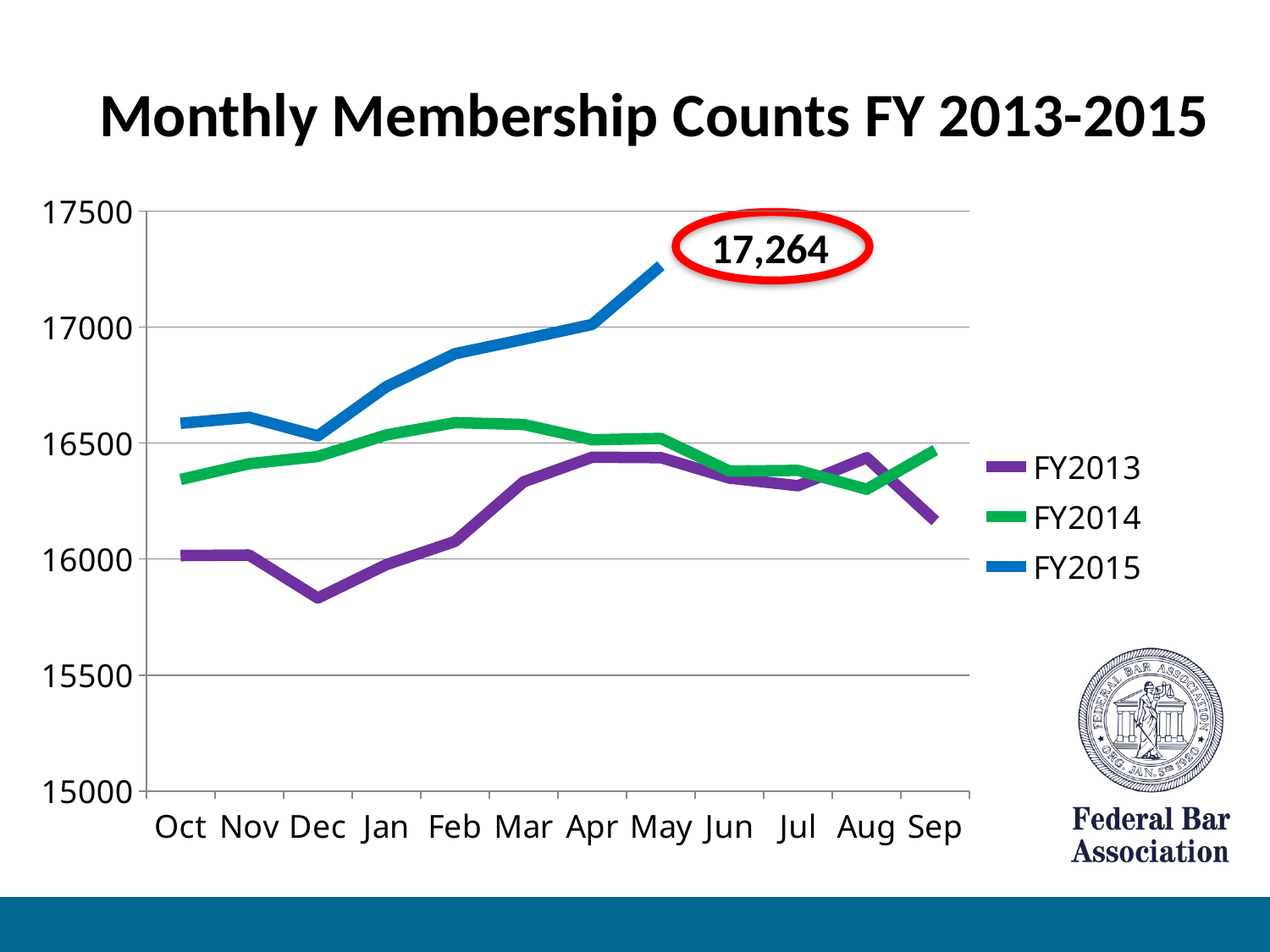
Does the FY2015 line rise or fall from Dec to May? rise In which month does the FY2015 line reach its highest value? May In which month does the FY2013 line reach its lowest value? Dec Is the FY2014 value for Aug greater or less than 16500? less Is the FY2013 value for Dec greater or less than 16000? less In Oct, which series has the higher value, FY2013 or FY2015? FY2015 How many months are shown along the x axis? 12 What kind of chart is shown on the slide? line chart What is the FY2015 membership count for May, as labelled on the chart? 17,264 How many series does the legend list? 3 What is the title of the chart? Monthly Membership Counts FY 2013-2015 Is the FY2015 value for Feb greater or less than 17000? less